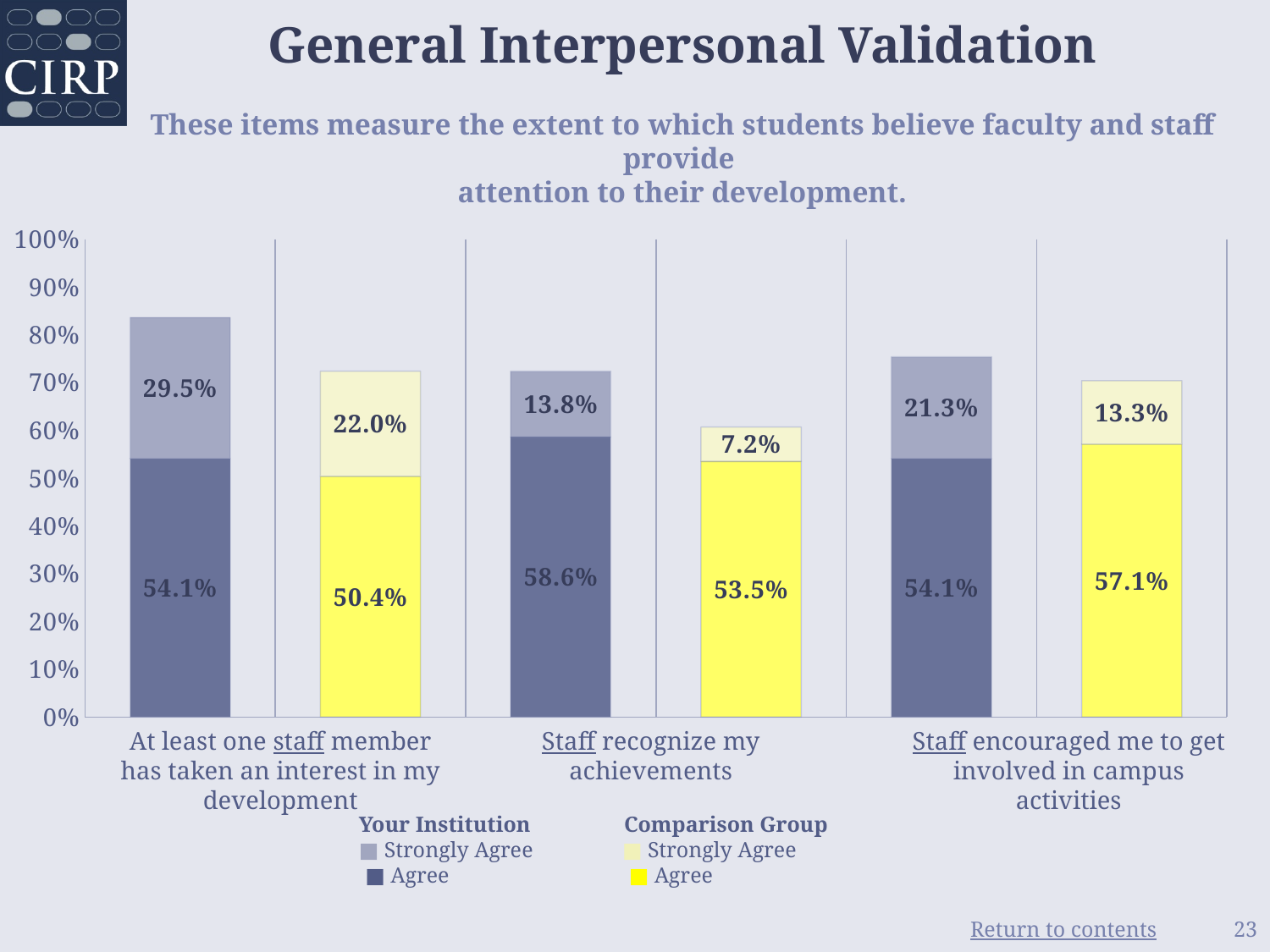
Which item has the lowest Strongly Agree percentage for the Comparison Group? Staff recognize my achievements What is the combined Agree and Strongly Agree percentage for Your Institution on 'At least one staff member has taken an interest in my development'? 83.6% How many survey items are shown on the x axis of the chart? 3 What is the difference between Your Institution's and the Comparison Group's Strongly Agree percentages for 'Staff recognize my achievements'? 6.6% What type of chart is shown on the slide? Stacked bar chart What percentage of students at Your Institution strongly agree that at least one staff member has taken an interest in their development? 29.5% What is the combined Agree and Strongly Agree percentage for the Comparison Group on 'Staff recognize my achievements'? 60.7% How many entries does the chart legend list? 4 Which item has the highest Agree percentage for Your Institution? Staff recognize my achievements What percentage of the Comparison Group strongly agree that staff encouraged them to get involved in campus activities? 13.3% What percentage of the Comparison Group agree that staff recognize their achievements? 53.5% For 'Staff encouraged me to get involved in campus activities', which group has the larger Agree percentage, Your Institution or the Comparison Group? Comparison Group